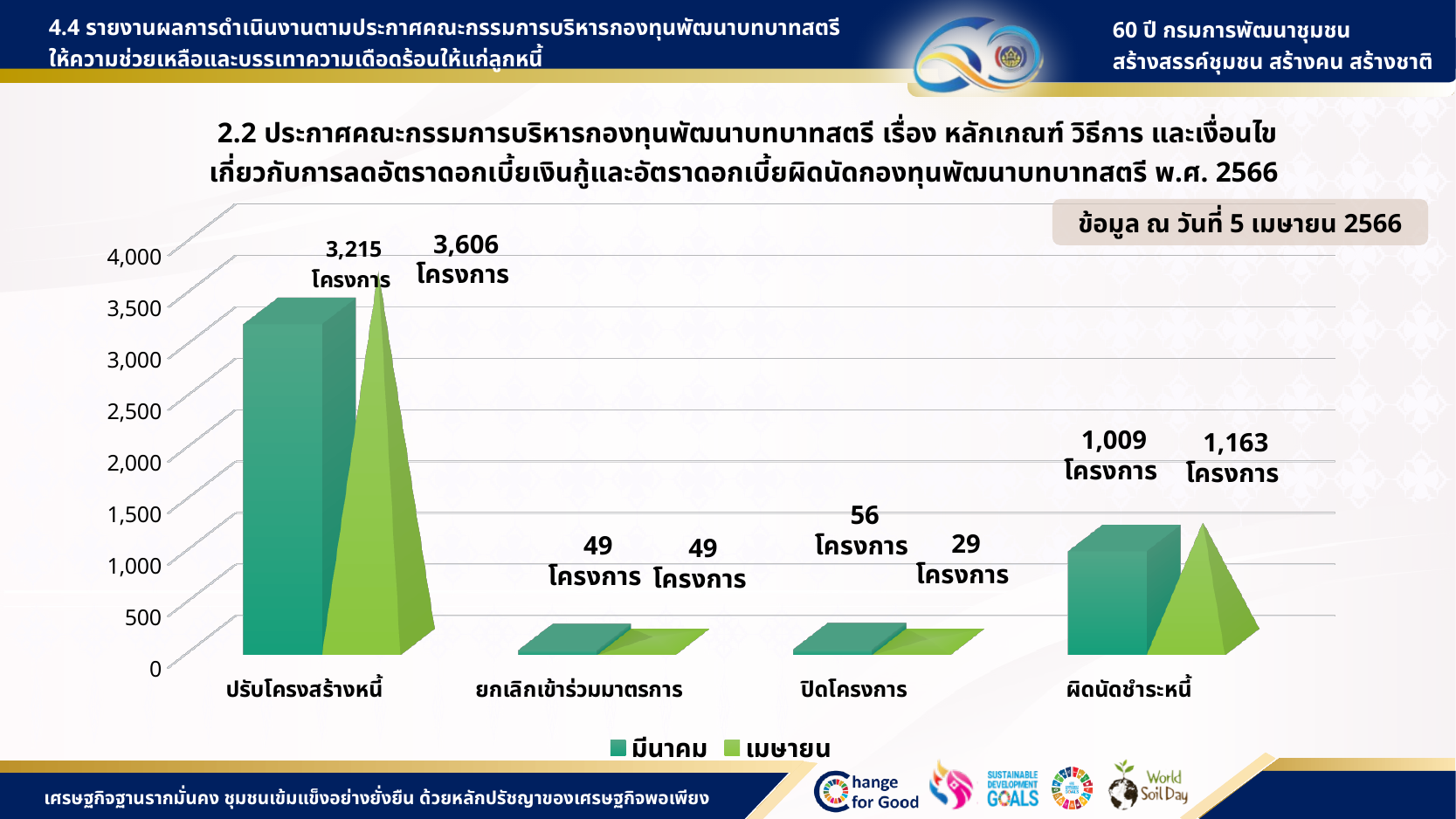
What is the difference between the เมษายน and มีนาคม values for ผิดนัดชำระหนี้? 154 What is the value for มีนาคม in the ปรับโครงสร้างหนี้ category? 3,215 โครงการ What is the difference between the เมษายน and มีนาคม values for ปรับโครงสร้างหนี้? 391 Which is larger for ปิดโครงการ: the มีนาคม value or the เมษายน value? มีนาคม What kind of chart is shown on the slide? Bar chart Which category has the lowest value for เมษายน? ปิดโครงการ What is the value for เมษายน in the ผิดนัดชำระหนี้ category? 1,163 โครงการ What is the value for มีนาคม in the ปิดโครงการ category? 56 โครงการ How many series does the legend list? 2 What is the value for เมษายน in the ยกเลิกเข้าร่วมมาตรการ category? 49 โครงการ How many categories are shown on the x axis? 4 Which category has the highest value for เมษายน? ปรับโครงสร้างหนี้